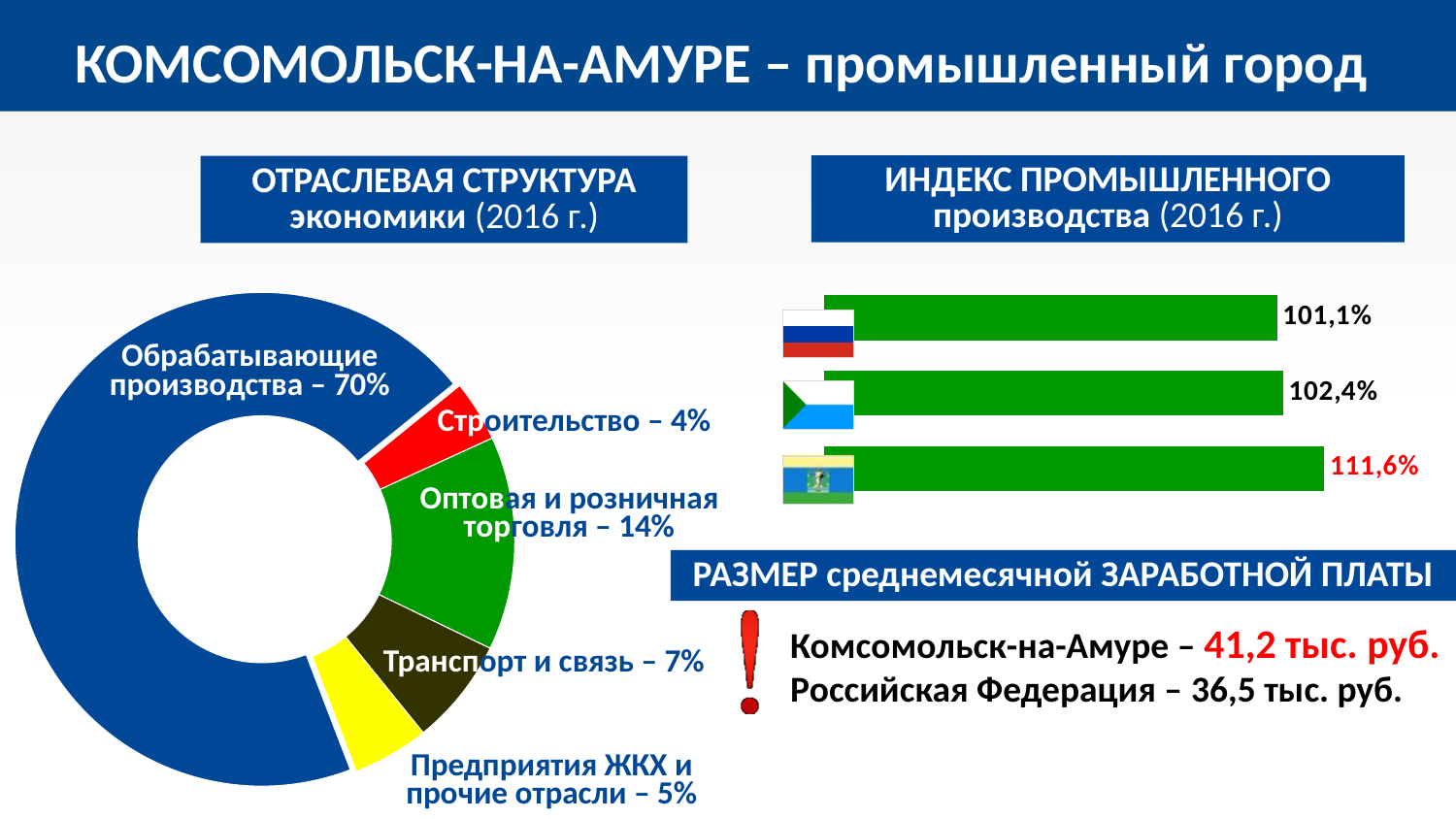
What type of chart is 'ИНДЕКС ПРОМЫШЛЕННОГО производства (2016 г.)'? Bar chart In the bar chart 'ИНДЕКС ПРОМЫШЛЕННОГО производства (2016 г.)', what is the value of the top bar? 101,1% In the donut chart 'ОТРАСЛЕВАЯ СТРУКТУРА экономики (2016 г.)', what share is 'Оптовая и розничная торговля'? 14% In the donut chart 'ОТРАСЛЕВАЯ СТРУКТУРА экономики (2016 г.)', which sector has the smallest share? Строительство In the donut chart 'ОТРАСЛЕВАЯ СТРУКТУРА экономики (2016 г.)', which is larger: 'Предприятия ЖКХ и прочие отрасли' or 'Строительство'? Предприятия ЖКХ и прочие отрасли In the donut chart 'ОТРАСЛЕВАЯ СТРУКТУРА экономики (2016 г.)', what share is 'Транспорт и связь'? 7% In the donut chart 'ОТРАСЛЕВАЯ СТРУКТУРА экономики (2016 г.)', how many sectors are shown? 5 In the donut chart 'ОТРАСЛЕВАЯ СТРУКТУРА экономики (2016 г.)', which sector has the largest share? Обрабатывающие производства In the bar chart 'ИНДЕКС ПРОМЫШЛЕННОГО производства (2016 г.)', how many bars are shown? 3 In the donut chart 'ОТРАСЛЕВАЯ СТРУКТУРА экономики (2016 г.)', what is the difference in percentage points between 'Оптовая и розничная торговля' and 'Транспорт и связь'? 7 In the bar chart 'ИНДЕКС ПРОМЫШЛЕННОГО производства (2016 г.)', what is the value of the bottom bar? 111,6% In the donut chart 'ОТРАСЛЕВАЯ СТРУКТУРА экономики (2016 г.)', what share is 'Обрабатывающие производства'? 70%